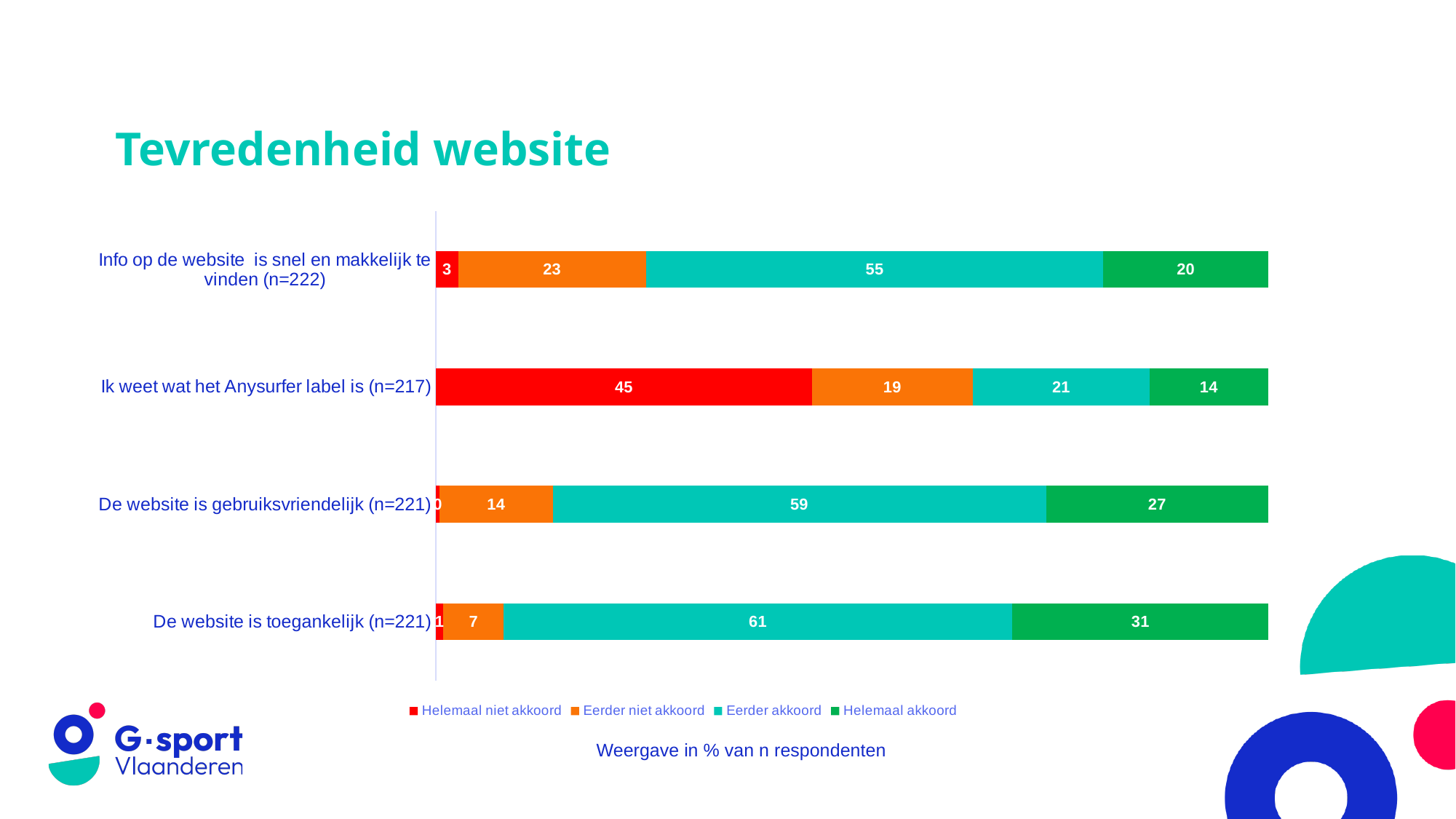
What is the 'Eerder akkoord' value for 'De website is toegankelijk (n=221)'? 61 How many series does the legend list? 4 Which is larger: the 'Eerder niet akkoord' value for 'Info op de website is snel en makkelijk te vinden (n=222)' or for 'Ik weet wat het Anysurfer label is (n=217)'? Info op de website is snel en makkelijk te vinden (n=222) What type of chart is shown on the slide? Stacked bar chart What is the difference between the 'Eerder akkoord' values for 'De website is gebruiksvriendelijk (n=221)' and 'Info op de website is snel en makkelijk te vinden (n=222)'? 4 What is the 'Helemaal akkoord' value for 'Info op de website is snel en makkelijk te vinden (n=222)'? 20 How many categories (statements) are plotted in the chart? 4 Which statement has the lowest 'Eerder akkoord' value? Ik weet wat het Anysurfer label is (n=217) What is the 'Eerder niet akkoord' value for 'De website is gebruiksvriendelijk (n=221)'? 14 What is the 'Helemaal niet akkoord' value for 'Ik weet wat het Anysurfer label is (n=217)'? 45 Which statement has the highest 'Helemaal akkoord' value? De website is toegankelijk (n=221) What is the title of the slide containing the chart? Tevredenheid website